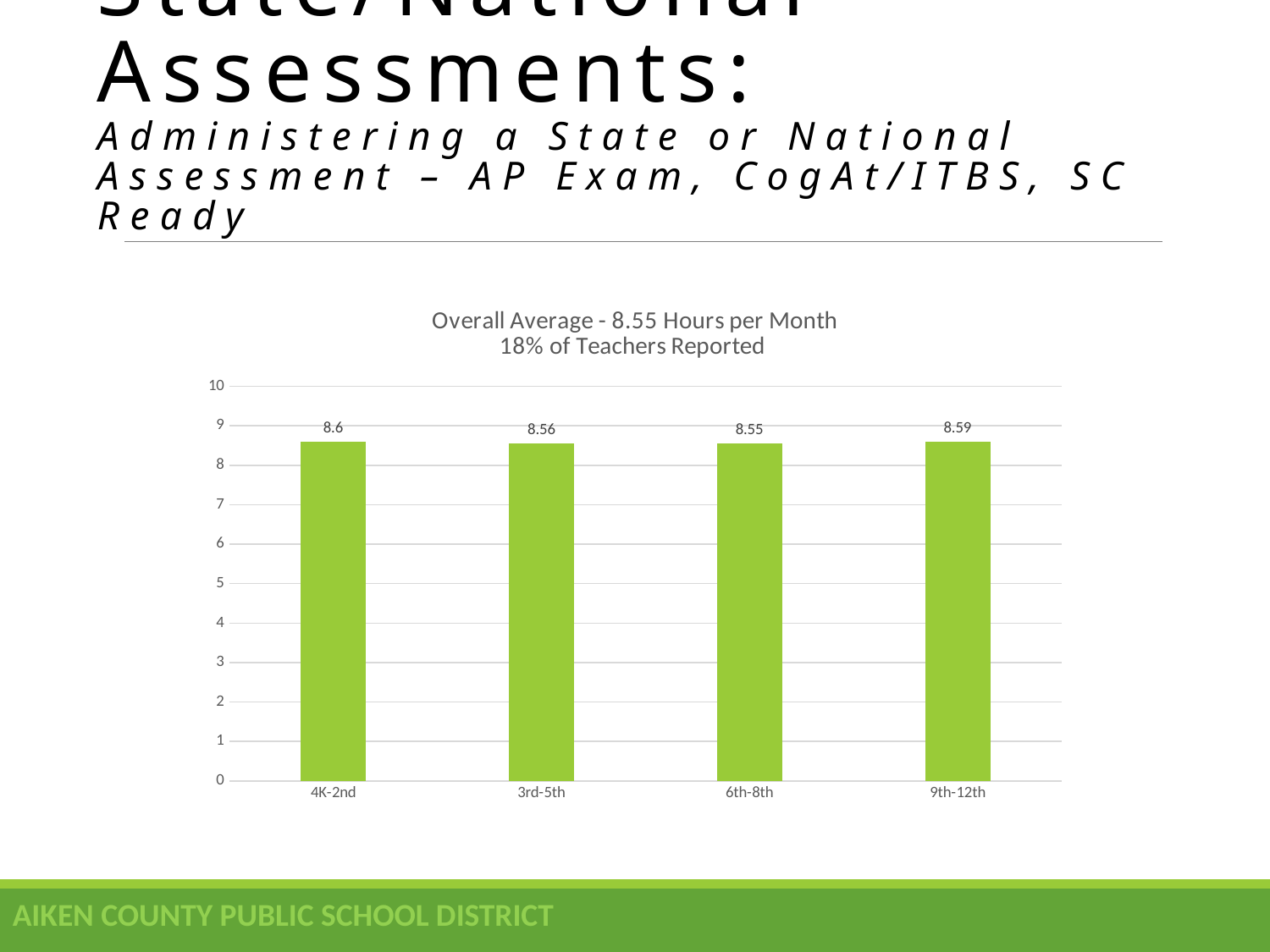
How many grade bands are shown on the x axis? 4 What is the value for 3rd-5th? 8.56 Which grade band has the highest value? 4K-2nd What is the value for 6th-8th? 8.55 What is the difference between the values for 4K-2nd and 6th-8th? 0.05 What kind of chart is shown on the slide? bar chart What overall average in hours per month does the chart title state? 8.55 Hours per Month Is the value for 6th-8th greater or less than 9? less What is the value for 4K-2nd? 8.6 Which grade band has the lowest value? 6th-8th What is the value for 9th-12th? 8.59 Which is larger, the value for 9th-12th or the value for 3rd-5th? 9th-12th